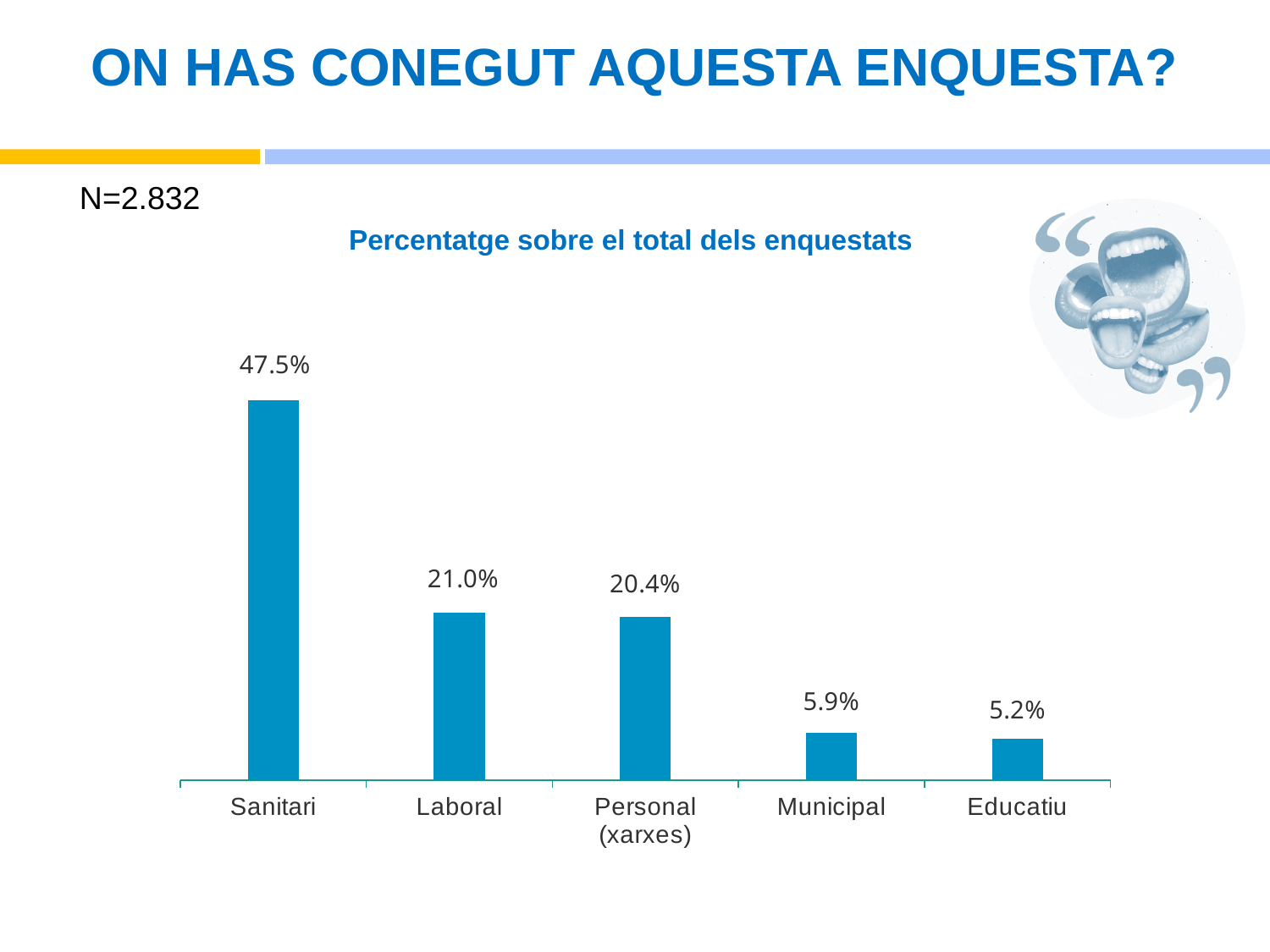
Which is larger, the value for Laboral or the value for Municipal? Laboral What is the value for Educatiu? 5.2% How many categories are shown on the x axis? 5 What is the value for Personal (xarxes)? 20.4% Which category has the lowest value? Educatiu What is the difference between the values for Sanitari and Laboral? 26.5% What is the value for Municipal? 5.9% What kind of chart is shown on the slide? Bar chart Which category has the highest value? Sanitari What is the value for Laboral? 21.0% What is the difference between the values for Municipal and Educatiu? 0.7% What is the value for Sanitari? 47.5%